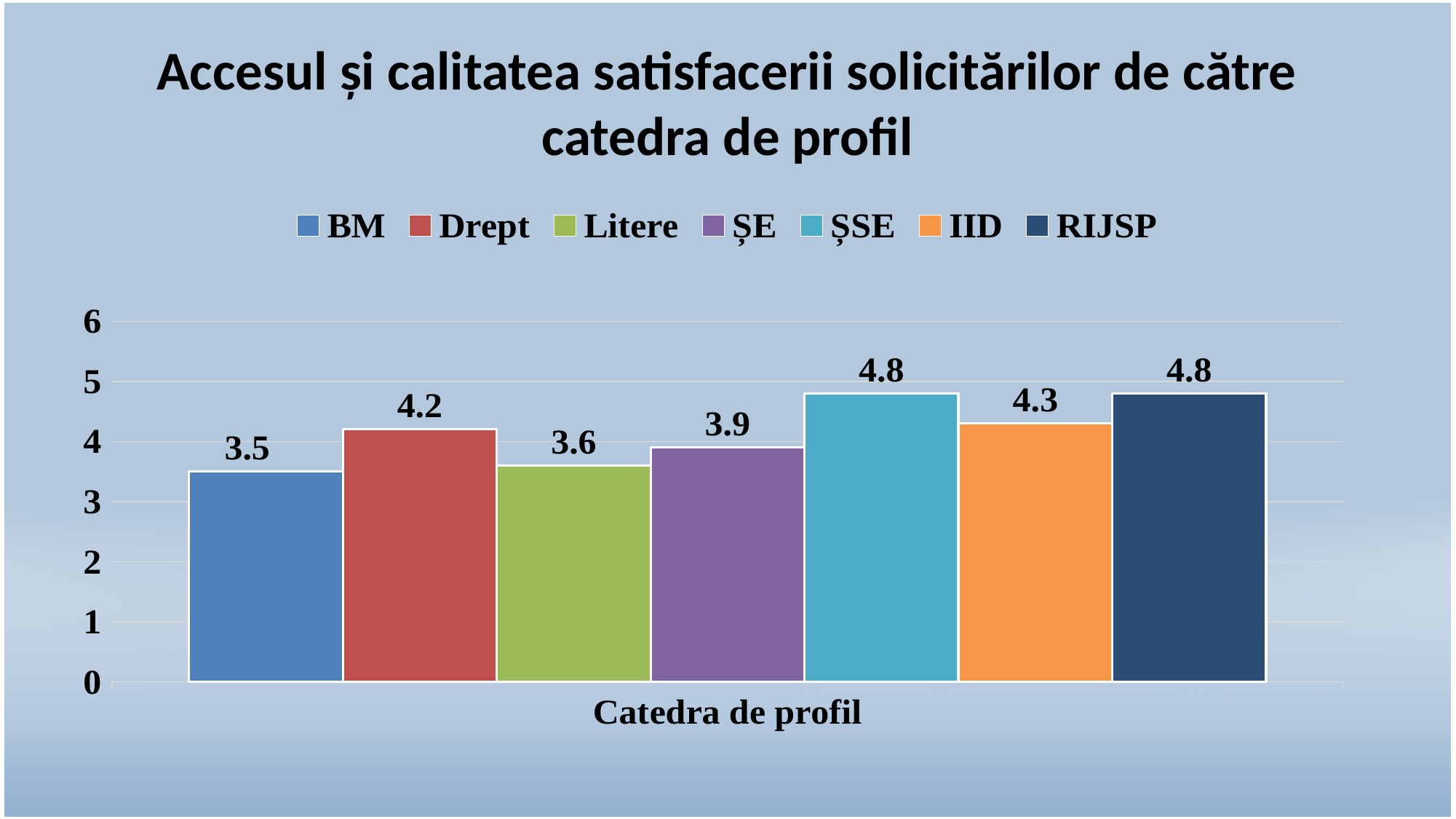
What is the value for ȘE? 3.9 What is the difference between the values for ȘSE and Litere? 1.2 What is the value for BM? 3.5 What is the value for Drept? 4.2 What is the value for IID? 4.3 How many series does the legend list? 7 What kind of chart is shown on the slide? bar chart What is the label of the horizontal axis? Catedra de profil Is the value for RIJSP greater or less than 4? greater Which series has the lowest value? BM What is the difference between the values for IID and BM? 0.8 Which is larger, the value for Drept or the value for Litere? Drept